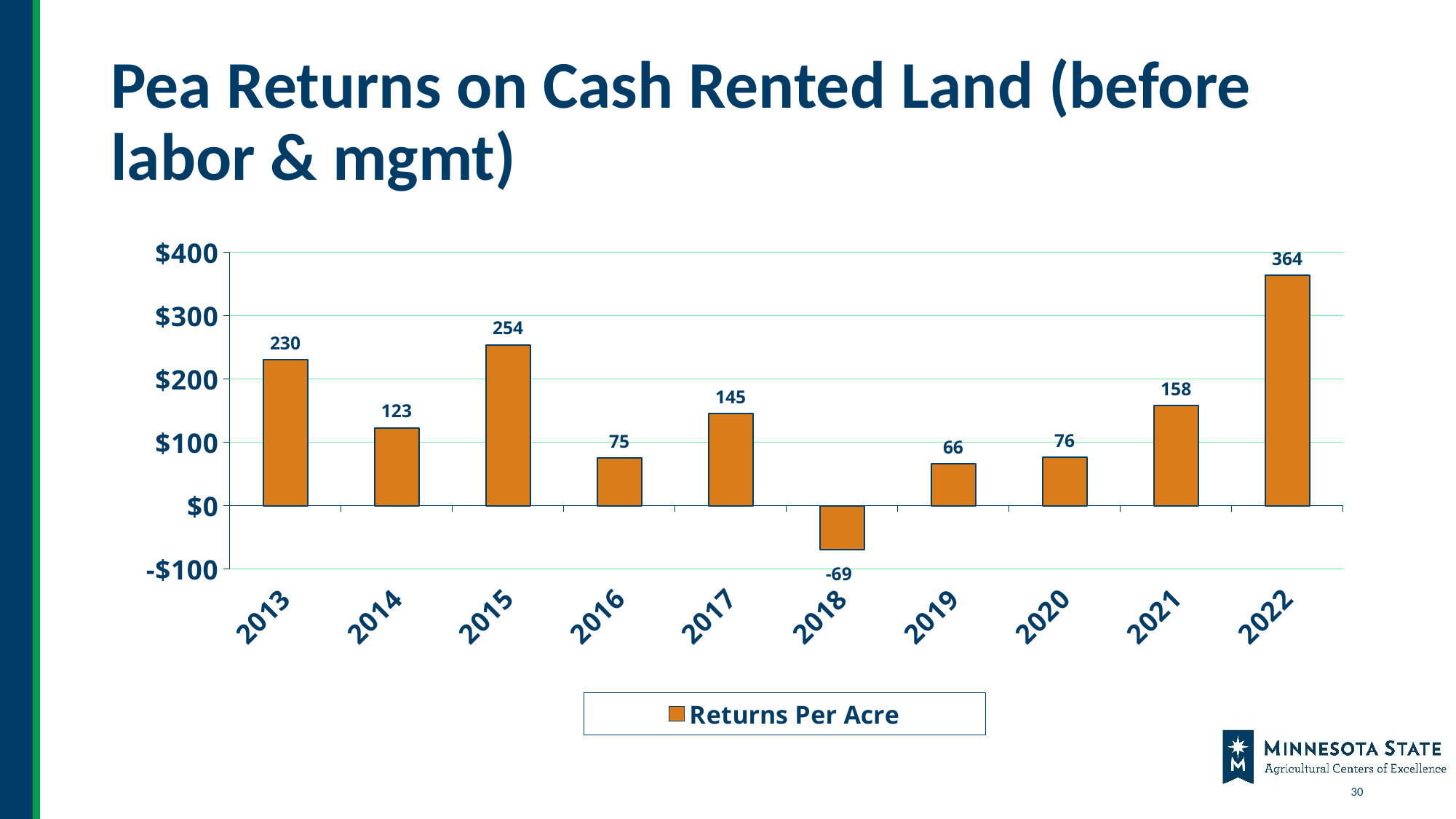
How many years are shown on the x axis? 10 What is the value of Returns Per Acre for 2018? -69 How many series does the legend list? 1 What kind of chart is shown on the slide? Bar chart What is the value of Returns Per Acre for 2013? 230 Which year has the lowest Returns Per Acre? 2018 Is the value for 2015 greater or less than $200? greater Which year has a larger Returns Per Acre, 2014 or 2017? 2017 Which year has the highest Returns Per Acre? 2022 What is the value of Returns Per Acre for 2021? 158 What is the difference between the Returns Per Acre for 2022 and 2015? 110 What is the legend entry for the series shown? Returns Per Acre